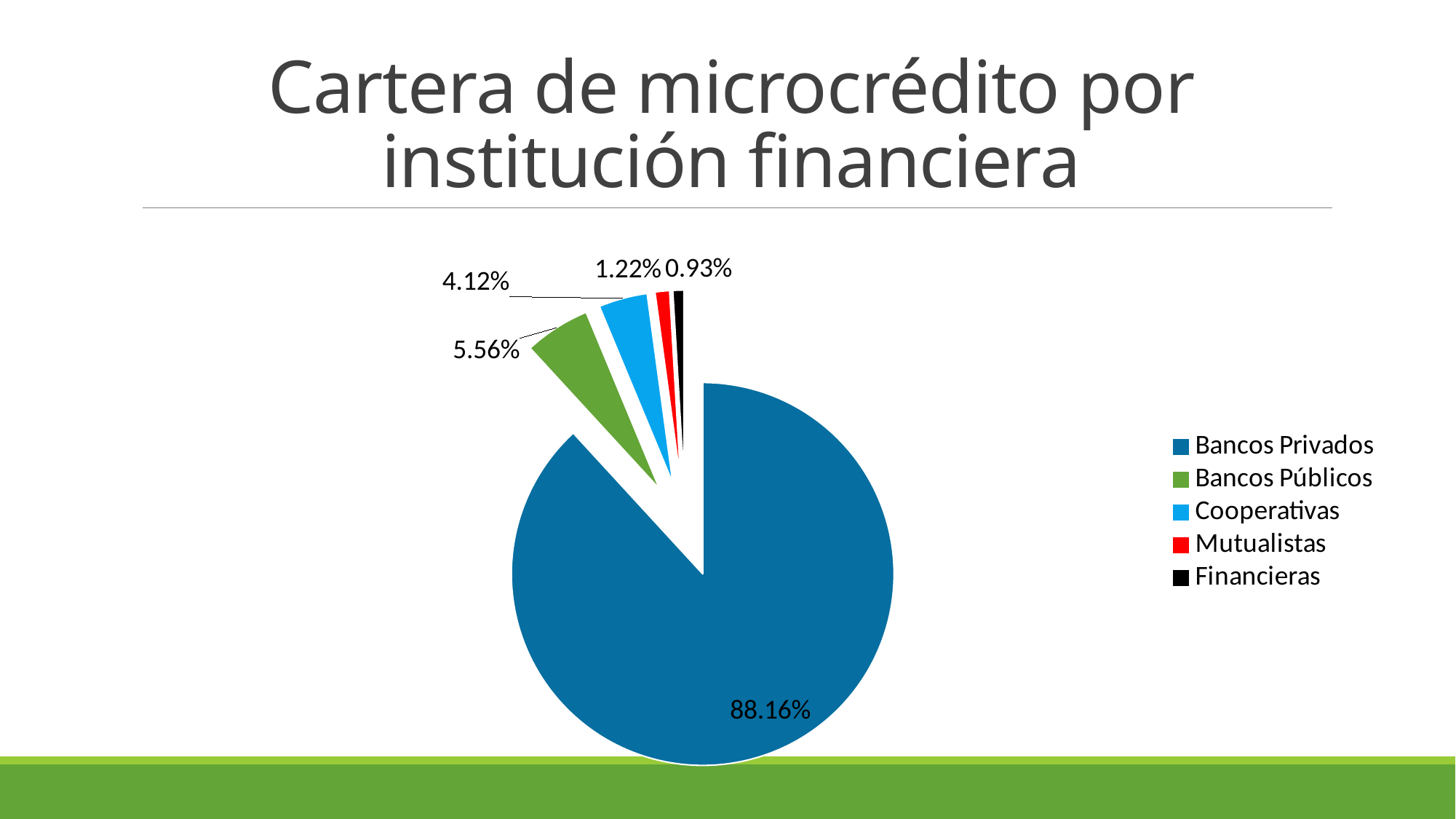
What is the difference in percentage points between Bancos Públicos and Cooperativas? 1.44 Which institution type has the largest share of the microcredit portfolio? Bancos Privados Which institution type has the smallest share of the microcredit portfolio? Financieras What kind of chart is shown on the slide? Pie chart Which has a larger share, Mutualistas or Financieras? Mutualistas What share of the microcredit portfolio do Bancos Privados hold? 88.16% What percentage is shown for Financieras? 0.93% How many categories does the legend list? 5 What is the title of the slide? Cartera de microcrédito por institución financiera What share of the pie is labelled for Bancos Públicos? 5.56% What percentage is shown for Mutualistas? 1.22% What percentage is shown for Cooperativas? 4.12%